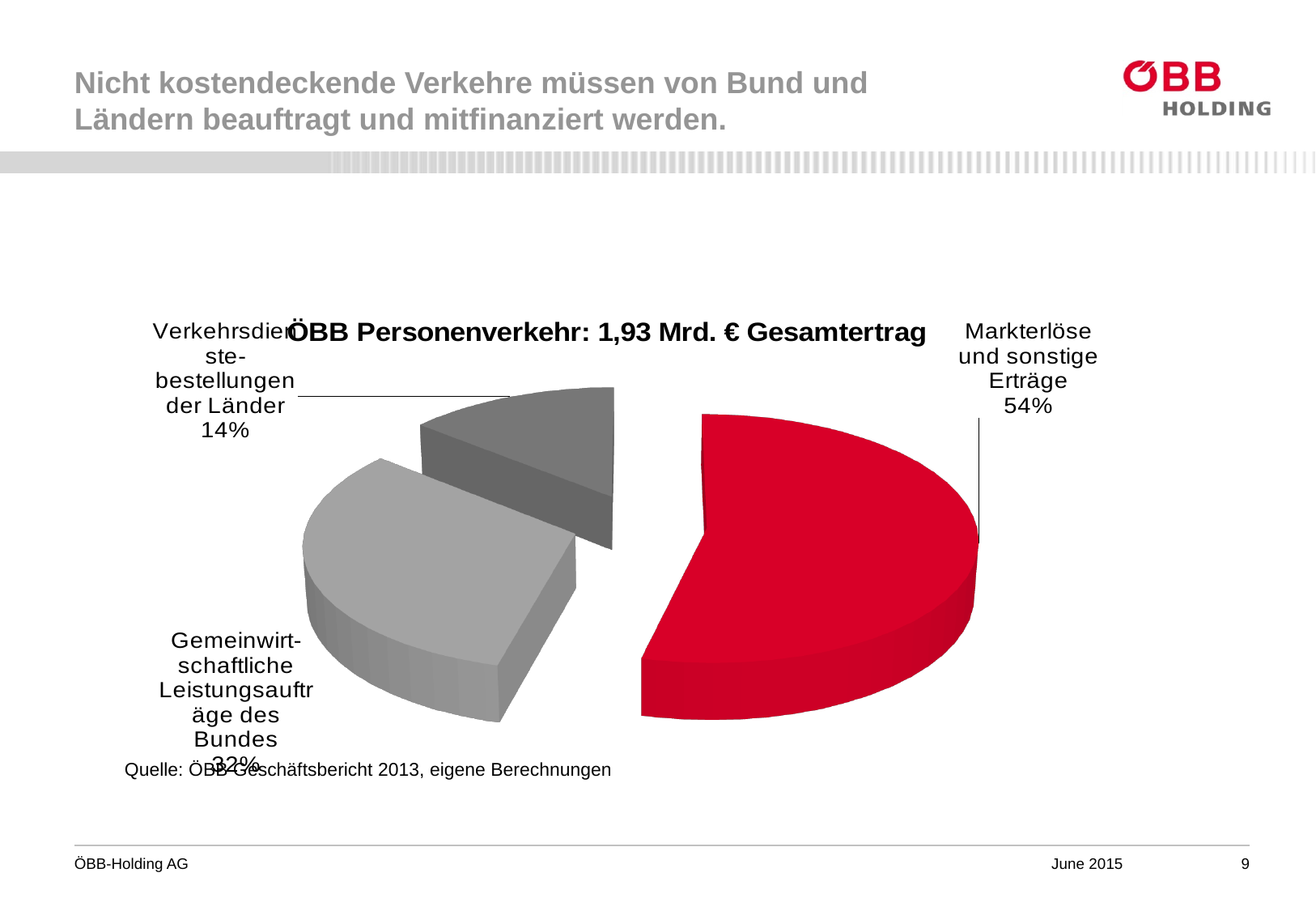
Which slice of the pie is the smallest? Verkehrsdienstebestellungen der Länder What share of the pie is Markterlöse und sonstige Erträge? 54% Which slice of the pie is the largest? Markterlöse und sonstige Erträge Which is larger: Gemeinwirtschaftliche Leistungsaufträge des Bundes or Verkehrsdienstebestellungen der Länder? Gemeinwirtschaftliche Leistungsaufträge des Bundes What share of the pie is Gemeinwirtschaftliche Leistungsaufträge des Bundes? 32% What total revenue does the chart title state for ÖBB Personenverkehr? 1,93 Mrd. € What kind of chart is shown on the slide? pie chart What is the title of the chart? ÖBB Personenverkehr: 1,93 Mrd. € Gesamtertrag What share of the pie is Verkehrsdienstebestellungen der Länder? 14% How many slices does the pie chart have? 3 What colour is the Markterlöse und sonstige Erträge slice? red What is the difference in percentage points between Markterlöse und sonstige Erträge and Verkehrsdienstebestellungen der Länder? 40 percentage points